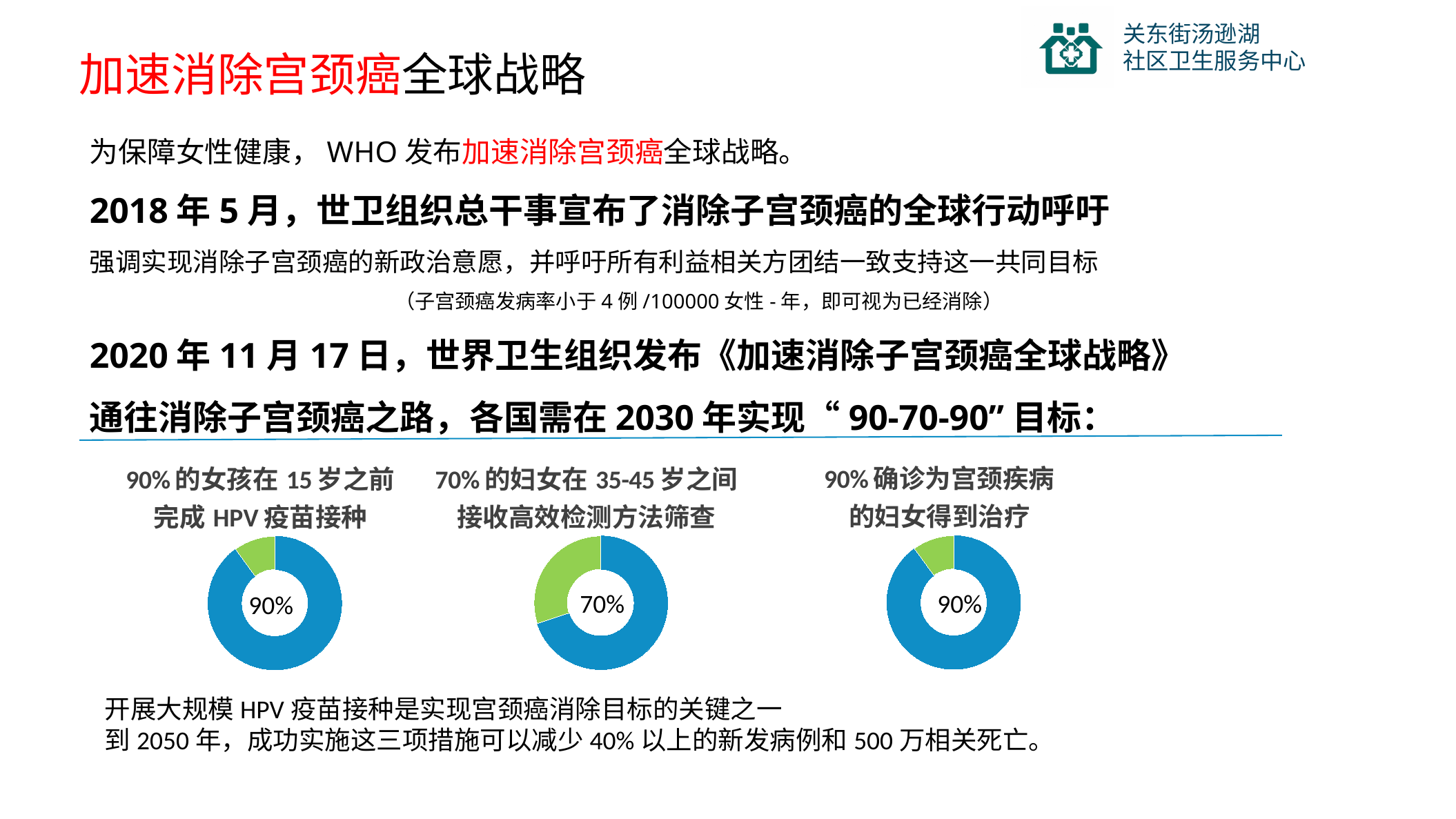
Is the value shown in the middle donut chart larger or smaller than the value in the right donut chart? Smaller What is the difference between the value in the left donut chart and the value in the middle donut chart? 20% How many donut charts are shown on the slide? 3 In the left donut chart (90% 的女孩在 15 岁之前完成 HPV 疫苗接种), what value is printed in the centre? 90% In the middle donut chart, what share of the ring is not covered by the blue slice? 30% In the middle donut chart (70% 的妇女在 35-45 岁之间接收高效检测方法筛查), what value is printed in the centre? 70% What colour is the larger slice in each of the three donut charts? Blue How many slices does each donut chart contain? 2 In the right donut chart (90% 确诊为宫颈疾病的妇女得到治疗), what value is printed in the centre? 90% Which of the three donut charts shows the lowest percentage? The middle chart (70%) What kind of chart is used to show the three "90-70-90" targets on the slide? Donut (pie) chart What colour is the smaller slice in each of the three donut charts? Green